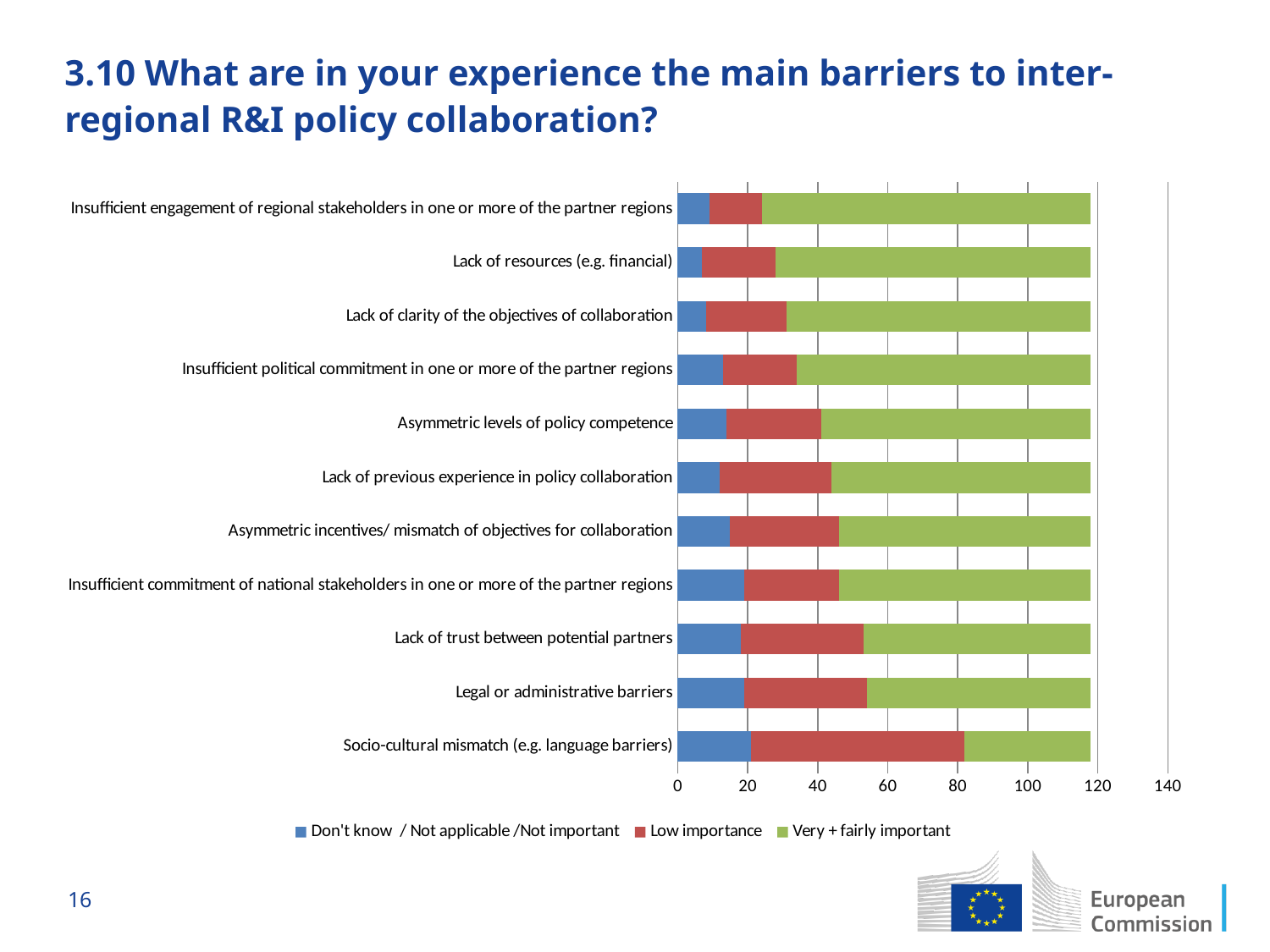
How many barrier categories are plotted in the chart? 11 Which category has the largest 'Low importance' segment? Socio-cultural mismatch (e.g. language barriers) Which has the larger 'Low importance' segment: 'Socio-cultural mismatch (e.g. language barriers)' or 'Lack of resources (e.g. financial)'? Socio-cultural mismatch (e.g. language barriers) Which has the larger 'Very + fairly important' segment: 'Insufficient engagement of regional stakeholders in one or more of the partner regions' or 'Lack of trust between potential partners'? Insufficient engagement of regional stakeholders in one or more of the partner regions Is the total bar length for 'Legal or administrative barriers' greater or less than 100? greater Which series is shown in red in the chart? Low importance Which category has the smallest 'Very + fairly important' segment? Socio-cultural mismatch (e.g. language barriers) Is the 'Don't know / Not applicable / Not important' value for 'Insufficient engagement of regional stakeholders in one or more of the partner regions' greater or less than 20? less Which category is listed at the top of the chart? Insufficient engagement of regional stakeholders in one or more of the partner regions What kind of chart is shown on the slide? Stacked bar chart Is the 'Very + fairly important' segment for 'Socio-cultural mismatch (e.g. language barriers)' greater or less than 60? less How many series does the legend list? 3